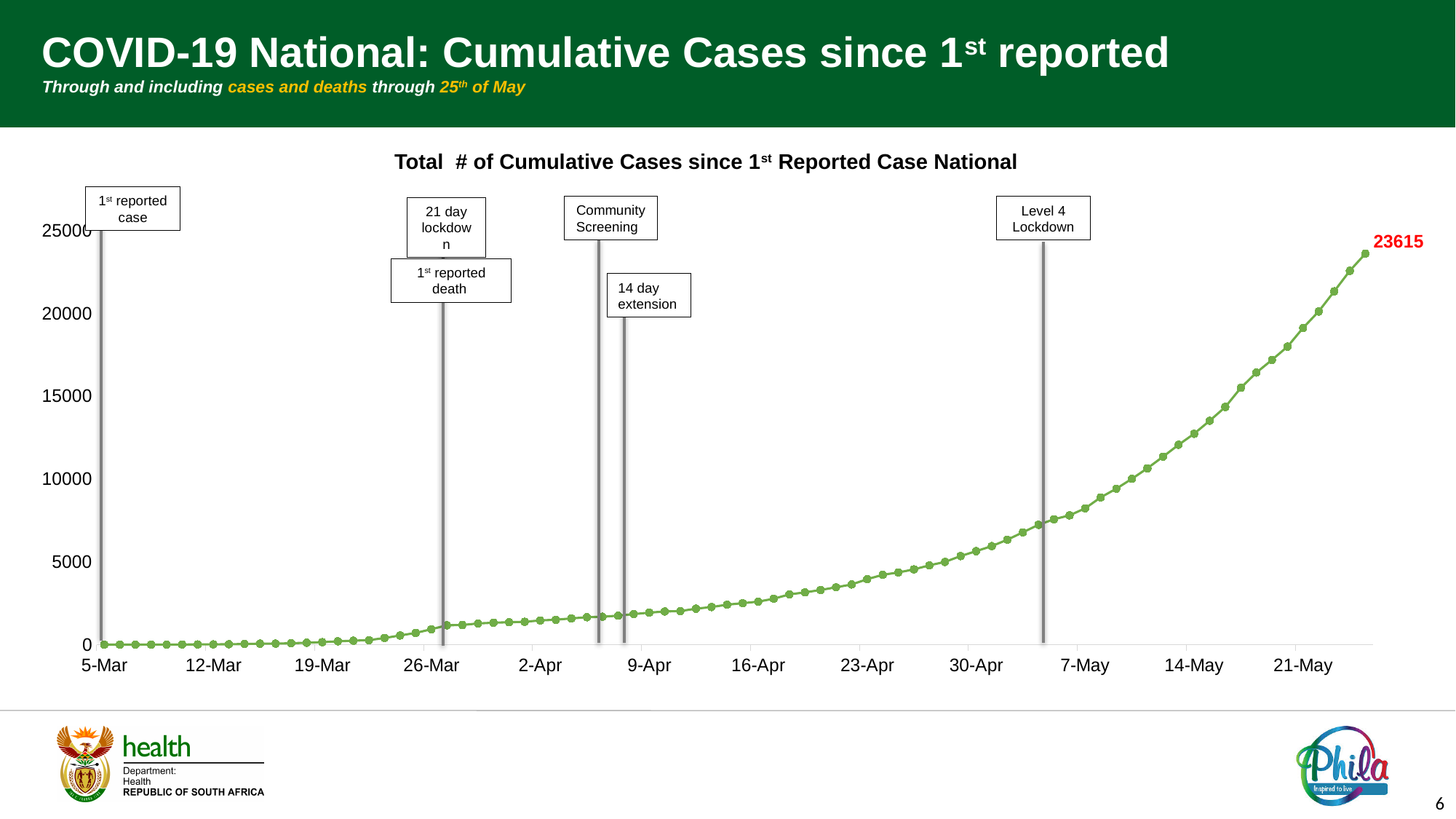
Which date has a larger value, 16-Apr or 14-May? 14-May Is the value for 7-May greater or less than 10000? less What event is marked by the vertical line annotation nearest to 5-May on the chart? Level 4 Lockdown Is the value for 30-Apr greater or less than 10000? less Do the cumulative case values rise or fall from 5-Mar to the end of the series? rise What is the highest value shown on the chart? 23615 Is the value for 14-May greater or less than 10000? greater What kind of chart is shown on the slide? line chart What is the value of the last data point labelled on the chart? 23615 What is the title of the chart? Total # of Cumulative Cases since 1st Reported Case National